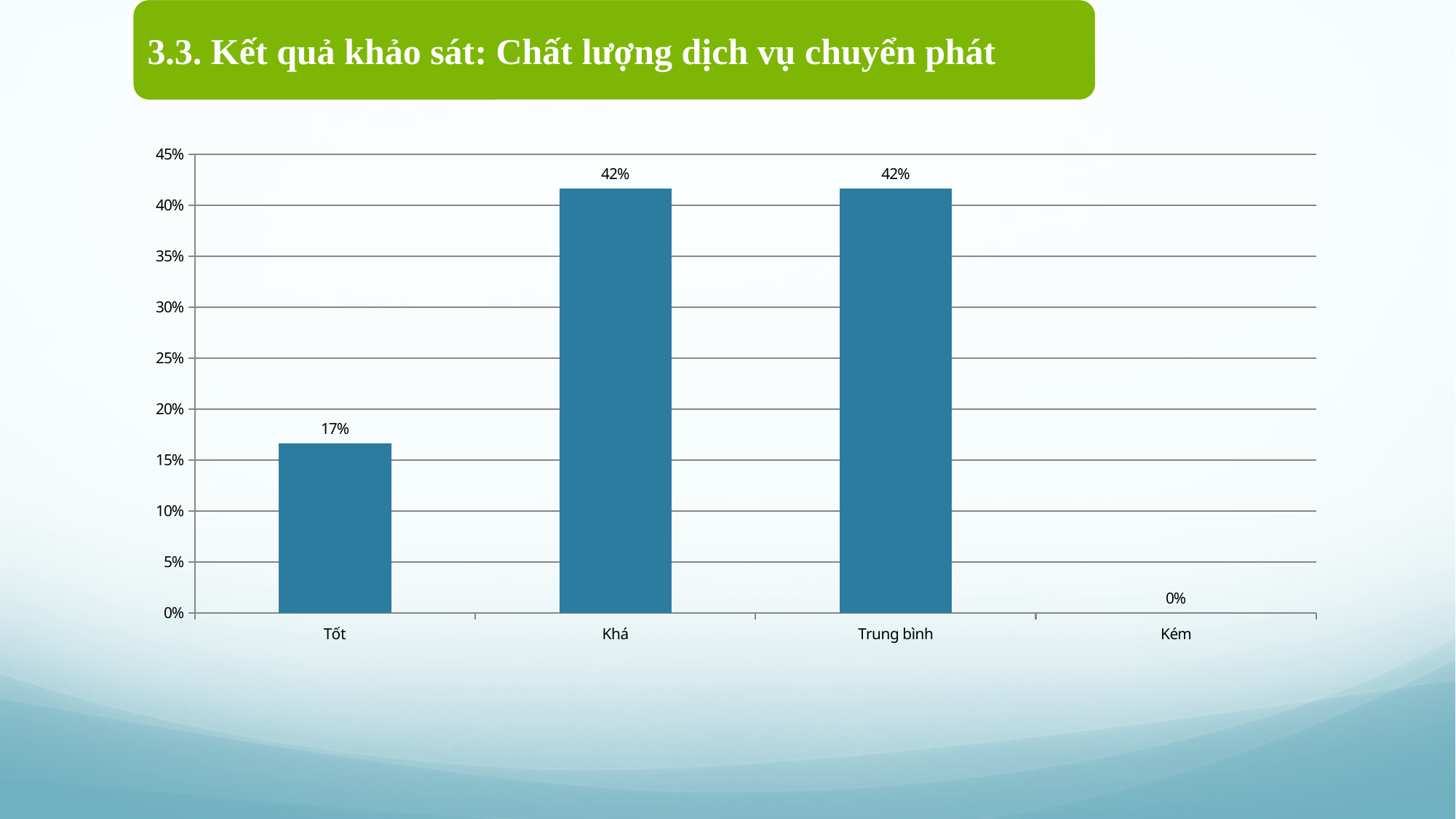
Is the value for Tốt greater or less than 20%? less What is the value for Tốt? 17% Which is larger, the value for Tốt or the value for Trung bình? Trung bình What is the value for Trung bình? 42% What is the value for Khá? 42% What is the difference between the values for Khá and Tốt? 25% What is the value for Kém? 0% What kind of chart is shown on the slide? bar chart How many categories are shown on the x axis? 4 What is the title of the slide? 3.3. Kết quả khảo sát: Chất lượng dịch vụ chuyển phát Which category has the lowest value? Kém Is the value for Khá greater or less than 40%? greater